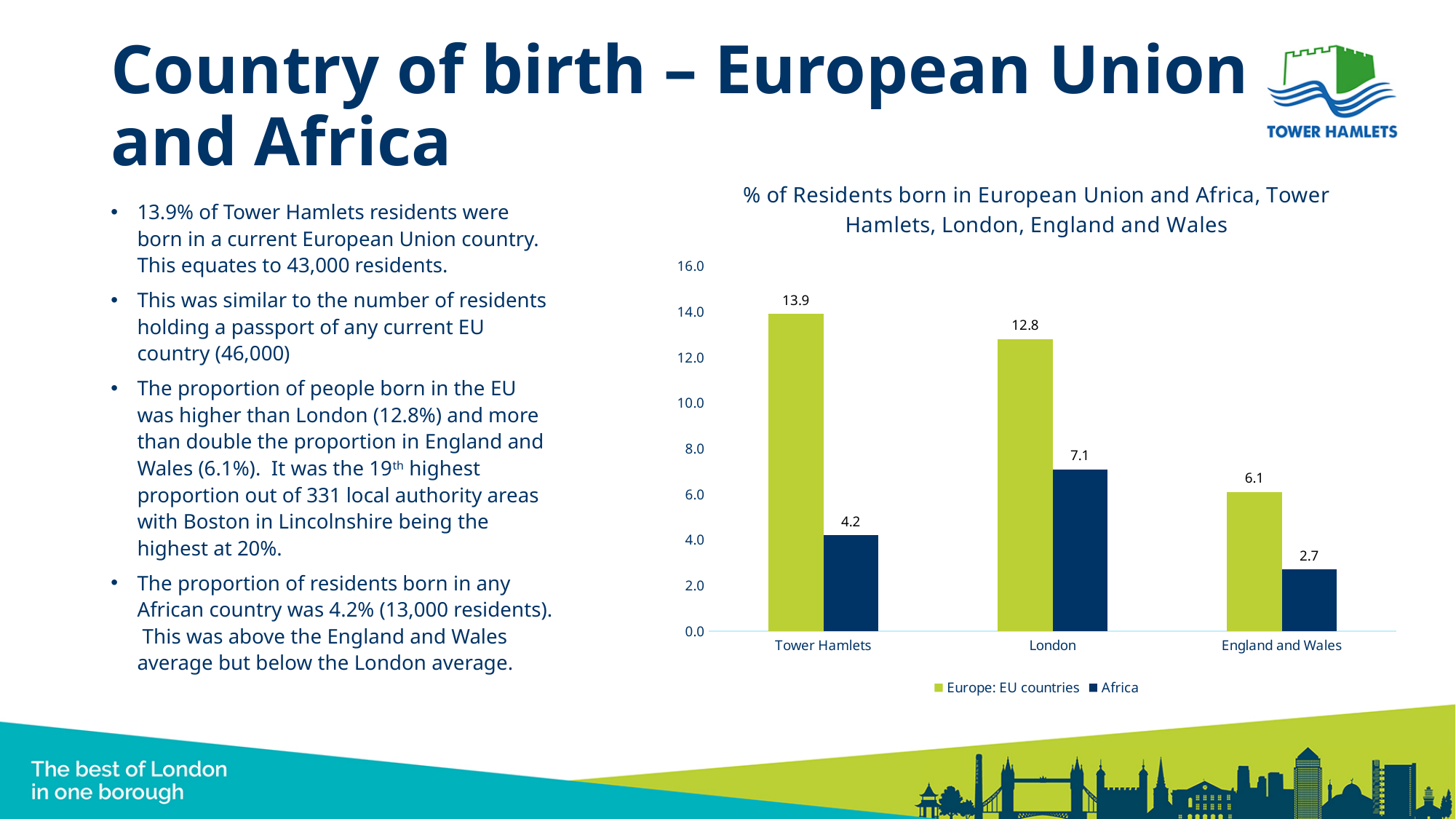
What is the value for Europe: EU countries in Tower Hamlets? 13.9 Which is larger: the Africa value for Tower Hamlets or the Africa value for London? London Which area has the highest value for Europe: EU countries? Tower Hamlets How many series does the legend list? 2 Which area has the lowest value for Africa? England and Wales Is the value for Europe: EU countries in England and Wales greater or less than 8.0? less What kind of chart is shown on the slide? Bar chart What is the value for Africa in England and Wales? 2.7 What is the value for Africa in London? 7.1 How many areas are shown on the x axis? 3 What is the difference between the Europe: EU countries values for Tower Hamlets and London? 1.1 What is the difference between the Europe: EU countries and Africa values for Tower Hamlets? 9.7